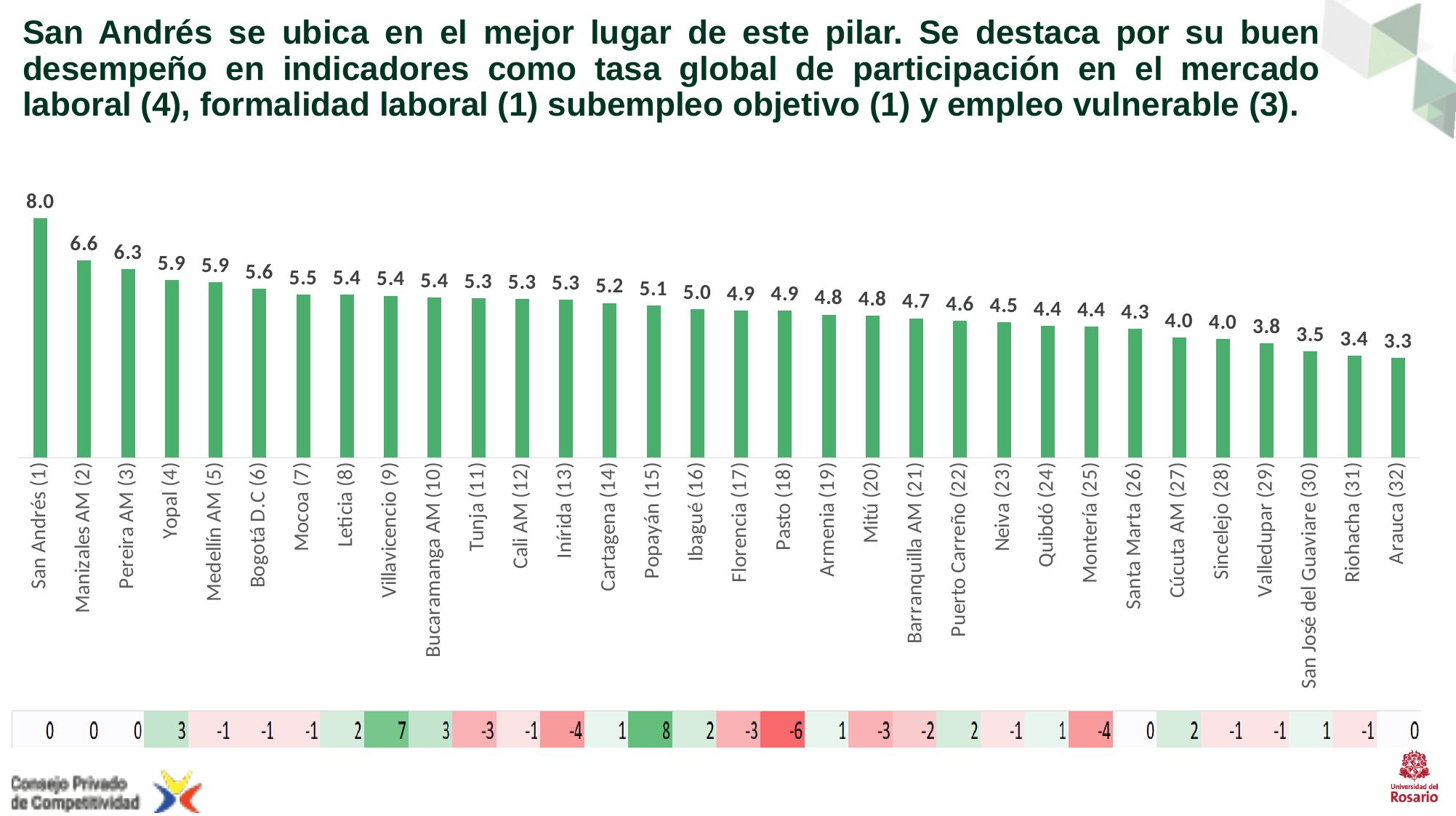
What is the difference between the values for San Andrés (1) and Arauca (32)? 4.7 What is the value shown for San Andrés (1)? 8.0 What is the value shown for Bogotá D.C (6)? 5.6 What is the value shown for Riohacha (31)? 3.4 Do the values rise or fall from left to right along the x axis? Fall How many cities are shown in the bar chart? 32 Which has a larger value, Bogotá D.C (6) or Cartagena (14)? Bogotá D.C (6) What is the difference between the values for Manizales AM (2) and Pereira AM (3)? 0.3 Which city has the highest value in the chart? San Andrés (1) What kind of chart is shown on the slide? Bar chart What is the value shown for Cúcuta AM (27)? 4.0 Which city has the lowest value in the chart? Arauca (32)